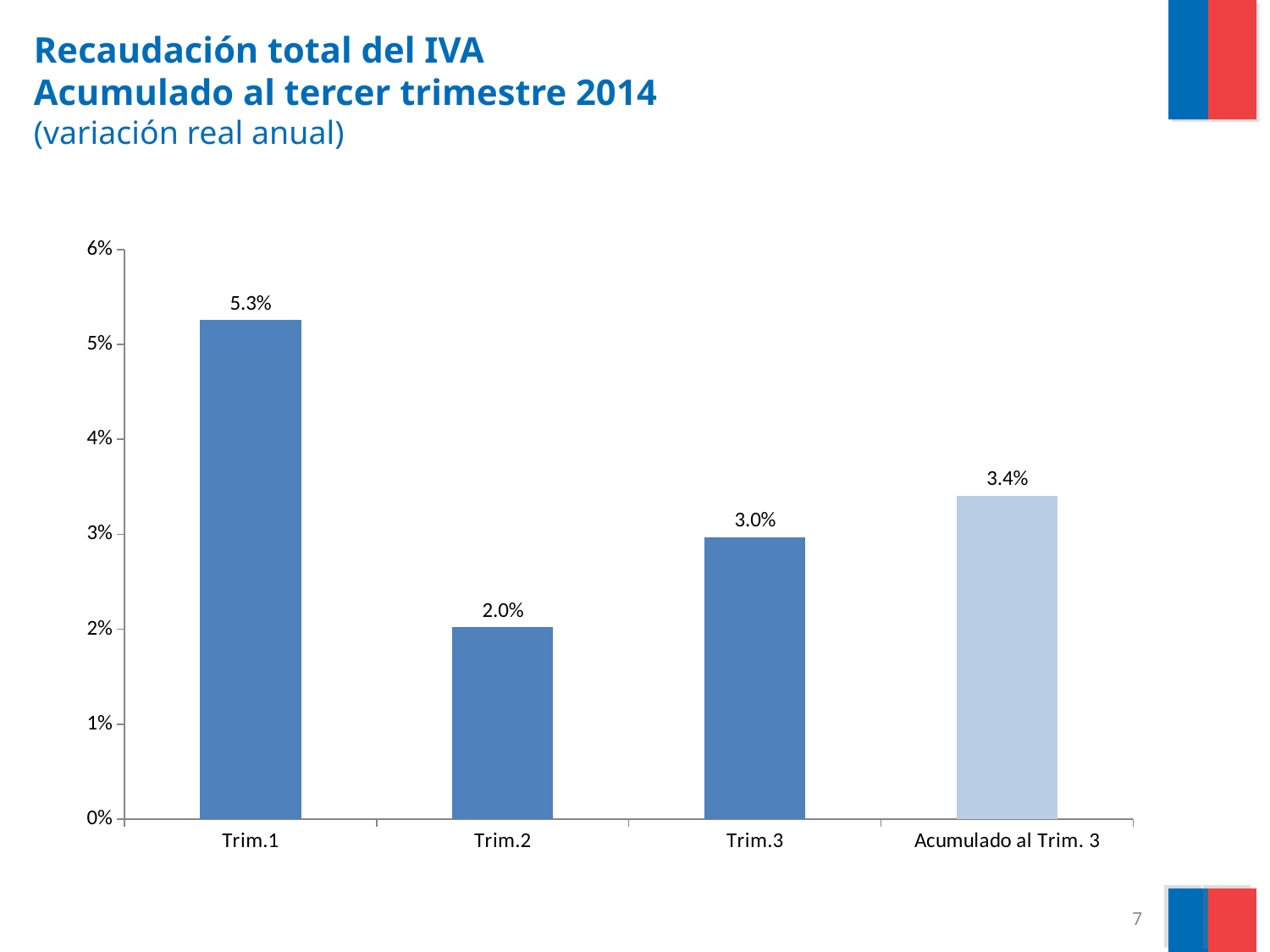
Which category has the lowest value? Trim.2 What is the value for Trim.3? 3.0% Which category has the highest value? Trim.1 What is the value for Acumulado al Trim. 3? 3.4% Which is larger, the value for Trim.3 or the value for Acumulado al Trim. 3? Acumulado al Trim. 3 What is the value for Trim.2? 2.0% Is the value for Trim.1 greater or less than 5%? greater What is the title of the chart on the slide? Recaudación total del IVA Acumulado al tercer trimestre 2014 (variación real anual) What kind of chart is shown on the slide? bar chart What is the difference between the values for Trim.1 and Trim.2? 3.3% What is the value for Trim.1? 5.3% How many categories are shown on the x axis? 4